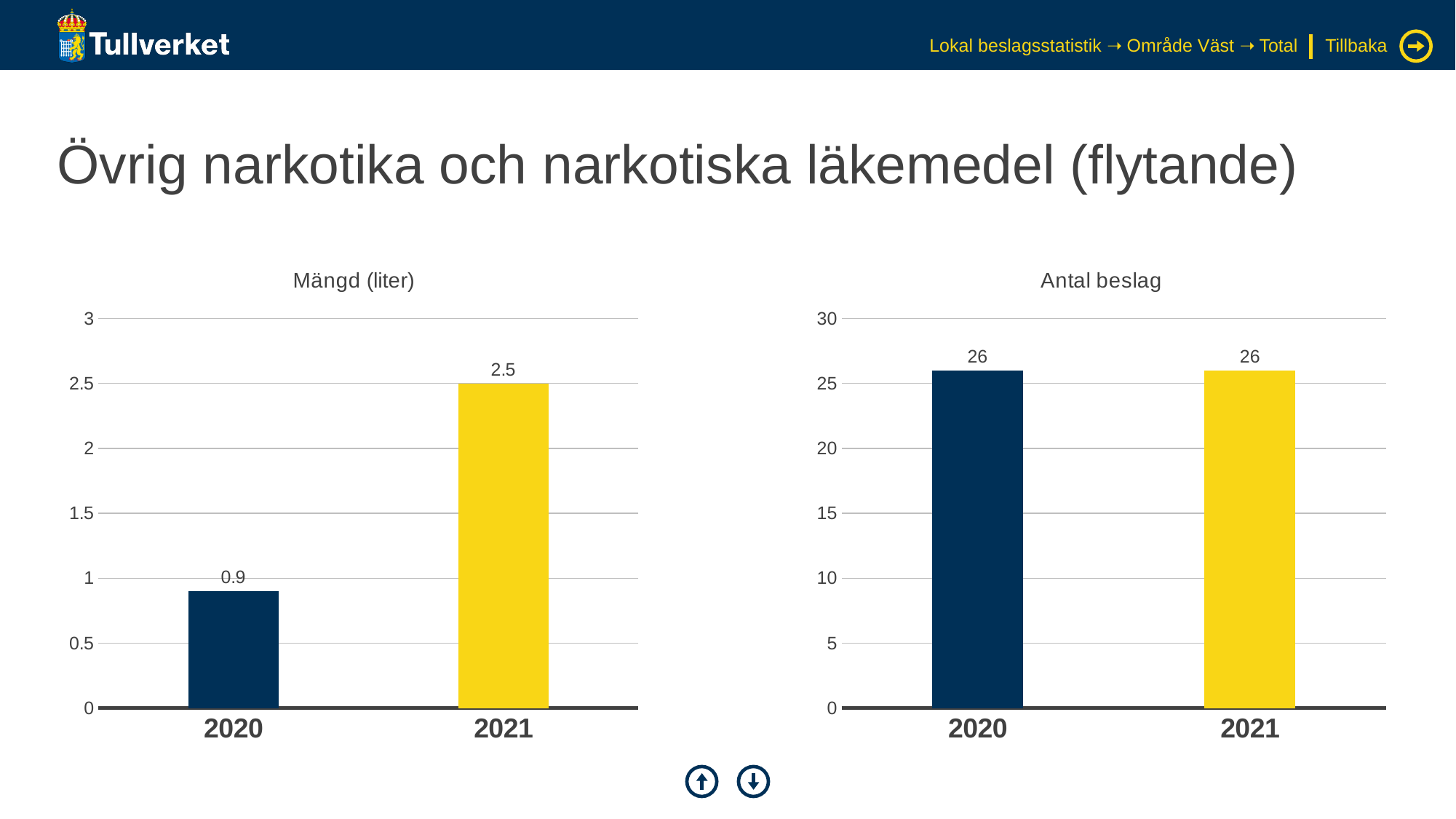
In the 'Mängd (liter)' chart, what is the difference between the 2021 and 2020 values? 1.6 In the 'Mängd (liter)' chart, what is the value for 2020? 0.9 In the 'Antal beslag' chart, what is the difference between the 2020 and 2021 values? 0 In the 'Mängd (liter)' chart, is the value for 2021 greater or less than 2? greater In the 'Mängd (liter)' chart, which year has the lowest value? 2020 In the 'Mängd (liter)' chart, which year has the highest value? 2021 In the 'Mängd (liter)' chart, what is the value for 2021? 2.5 In the 'Antal beslag' chart, what is the value for 2021? 26 In the 'Antal beslag' chart, what is the value for 2020? 26 What kind of chart is the 'Mängd (liter)' chart? bar chart In the 'Mängd (liter)' chart, do the values rise or fall from 2020 to 2021? rise In the 'Antal beslag' chart, how many years are shown on the x axis? 2